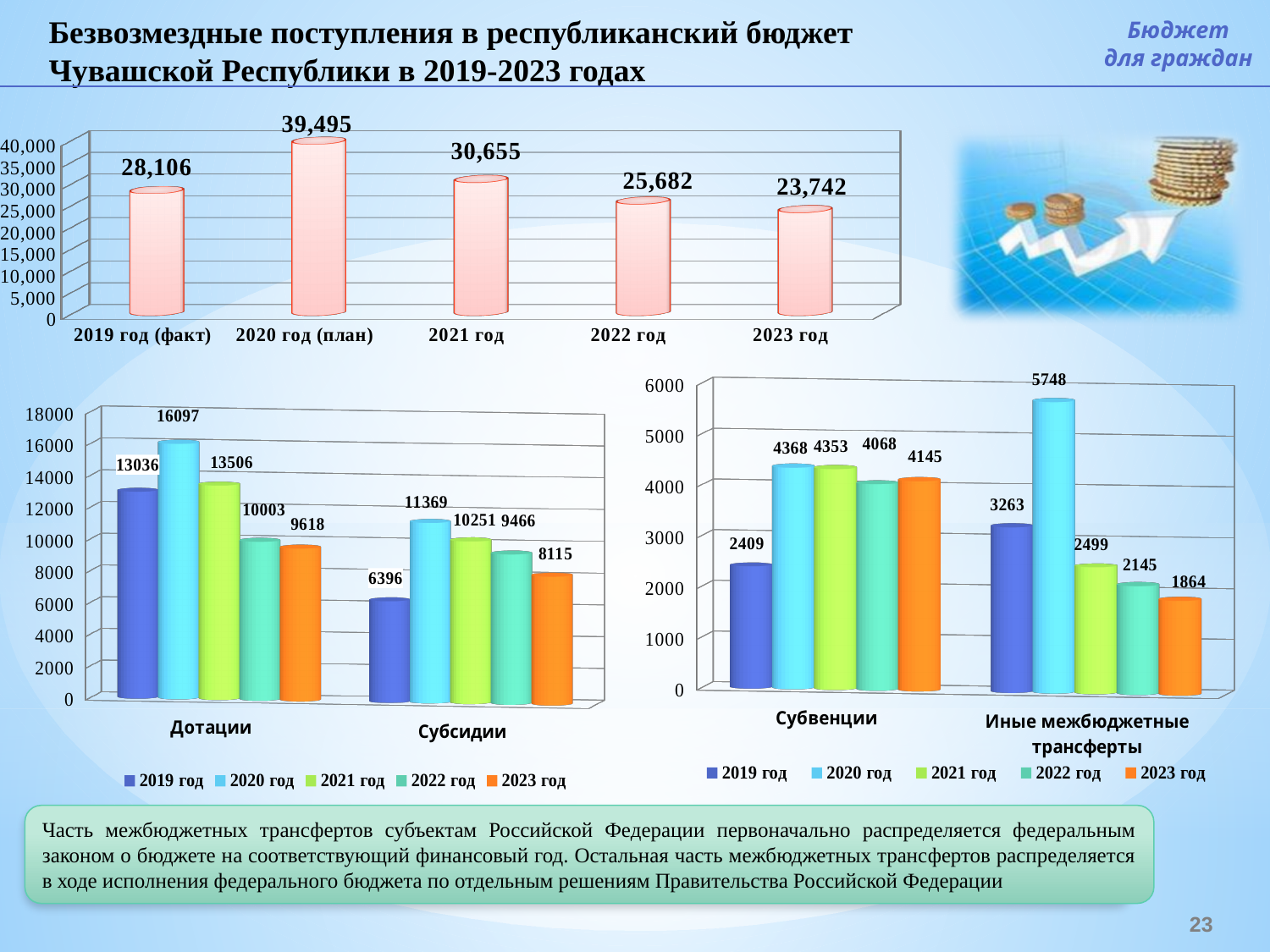
In the bottom-left chart, what is the difference between Дотации in 2020 год and in 2023 год? 6479 In the bottom-right chart, which year has the lowest value for Иные межбюджетные трансферты? 2023 год In the top chart, how many years are shown? 5 In the top chart, which year has the lowest value? 2023 год In the bottom-left chart, what is the value for Субсидии in 2020 год? 11369 In the bottom-right chart, what is the value for Иные межбюджетные трансферты in 2020 год? 5748 In the top chart, what is the value for 2020 год (план)? 39,495 In the bottom-left chart, how many series does the legend list? 5 In the bottom-right chart, which is larger for 2019 год: Субвенции or Иные межбюджетные трансферты? Иные межбюджетные трансферты In the top chart, what is the difference between the values for 2021 год and 2022 год? 4,973 What kind of chart is the top chart? Bar chart In the top chart, which year has the highest value? 2020 год (план)